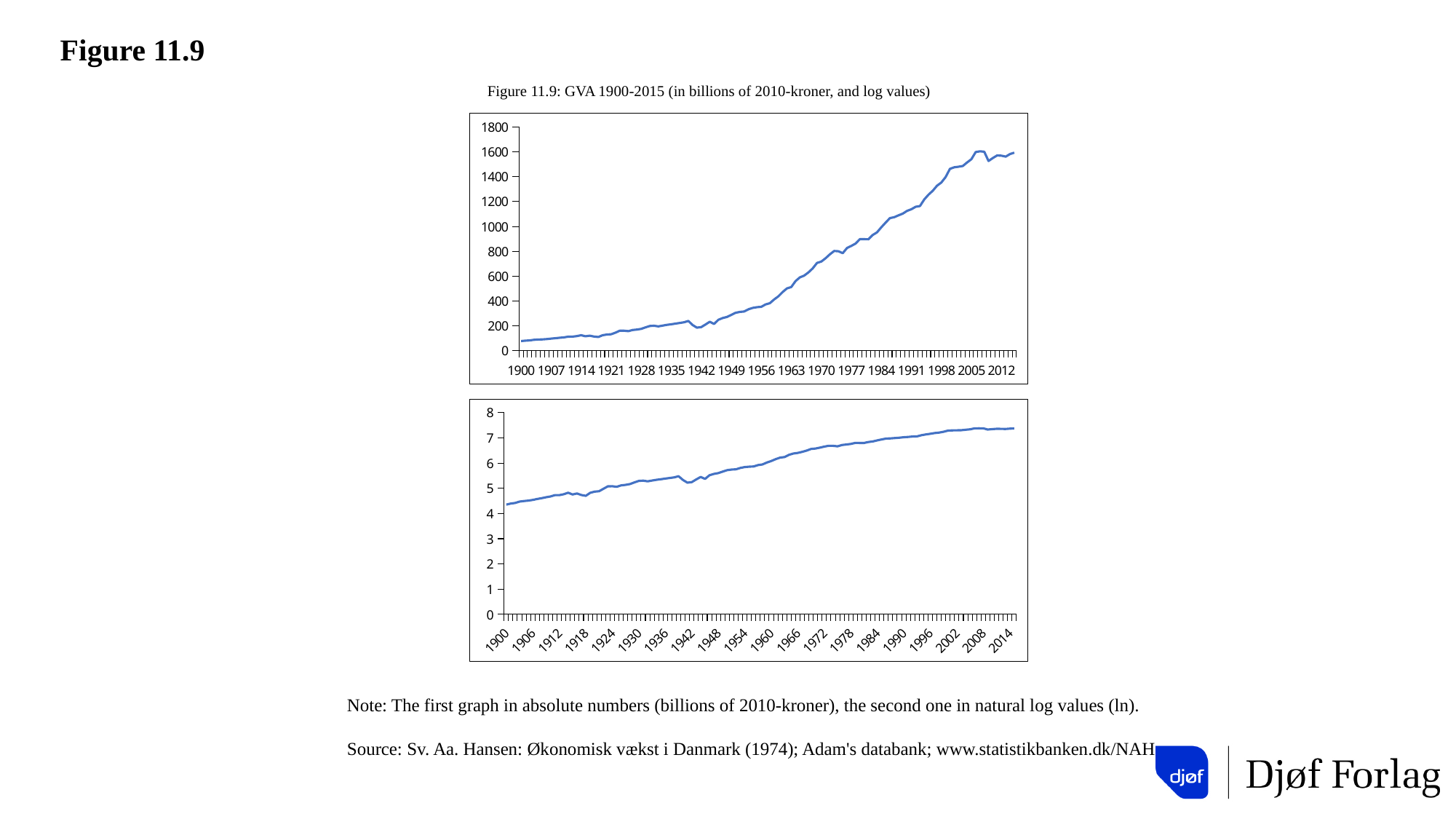
In the bottom chart, is the value for 1978 greater or less than 6? greater What is the title printed above the charts? Figure 11.9: GVA 1900-2015 (in billions of 2010-kroner, and log values) In the top chart, is the value for 1984 greater or less than 800? greater In the bottom chart (log values), do the values generally rise or fall from 1900 to 2014? rise In the bottom chart, is the value for 1900 greater or less than 5? less What kind of chart is the top chart on the slide? line chart What kind of chart is the bottom chart on the slide? line chart In the top chart (absolute numbers), do the values generally rise or fall from 1900 to 2015? rise